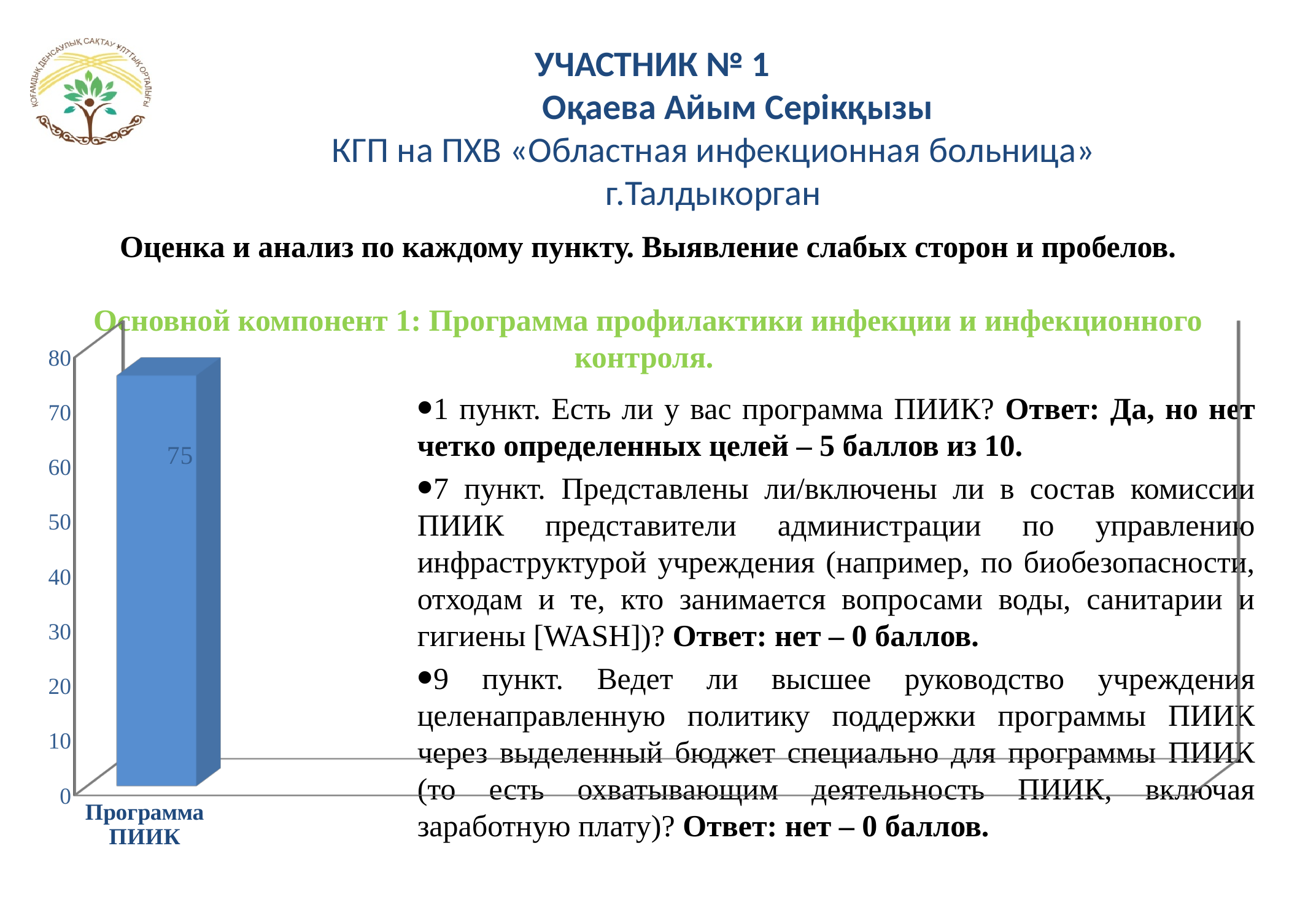
What is the label of the category on the x axis of the chart? Программа ПИИК Is the value for Программа ПИИК greater or less than 80? less What is the value of the bar for Программа ПИИК? 75 What kind of chart is shown on the slide? bar chart What is the highest tick value shown on the vertical axis of the chart? 80 Is the value for Программа ПИИК greater or less than 70? greater How many bars are plotted in the chart? 1